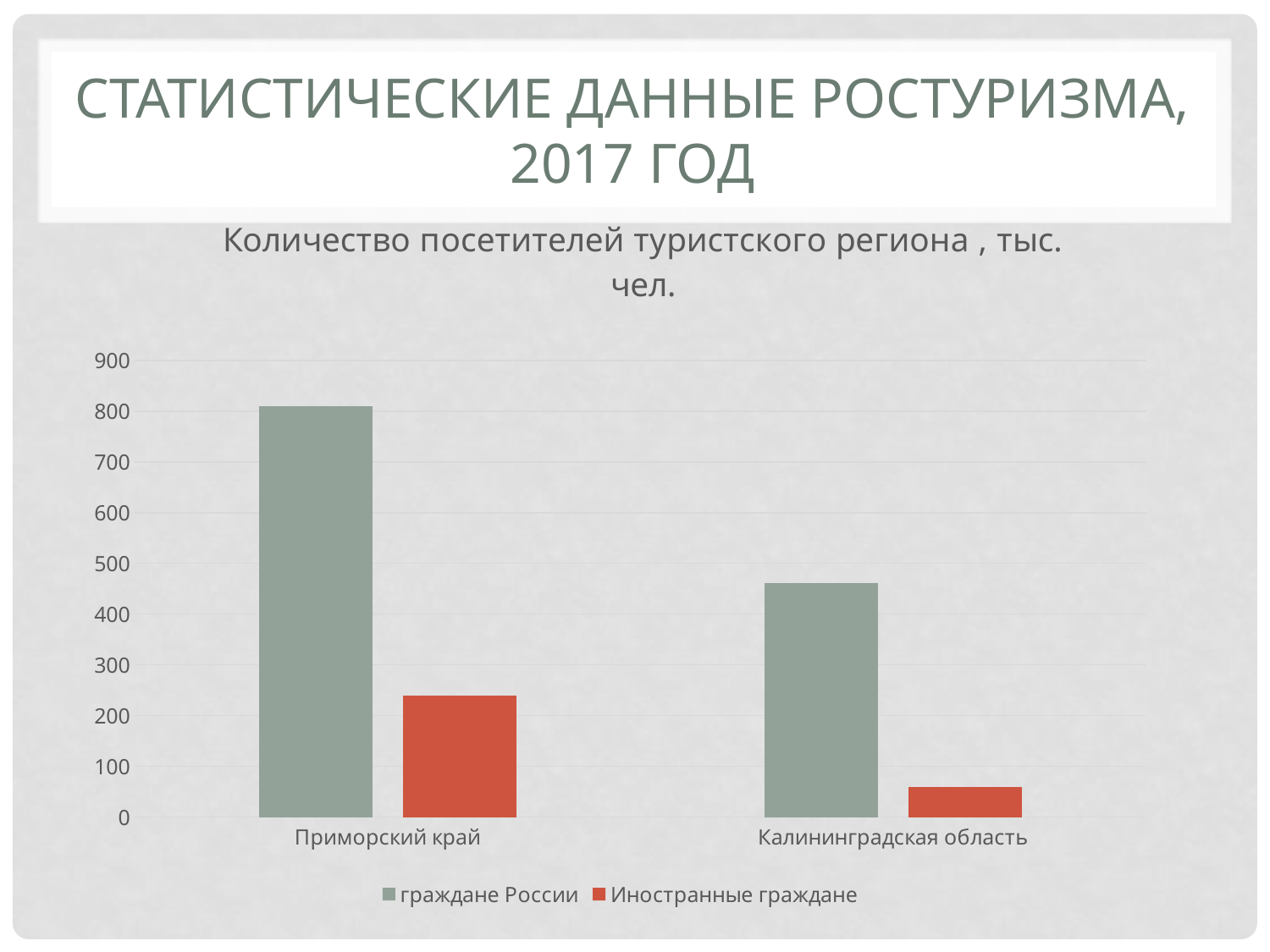
Which category has the highest value for граждане России? Приморский край Is the value for Иностранные граждане in Калининградская область greater or less than 100? less Is the value for Иностранные граждане in Приморский край greater or less than 200? greater Which series is shown in red? Иностранные граждане How many categories are shown on the x axis? 2 What is the title of the chart? Количество посетителей туристского региона , тыс. чел. How many series does the legend list? 2 Is the value for граждане России in Приморский край greater or less than 700? greater Which category has the lowest value for Иностранные граждане? Калининградская область In Калининградская область, which is larger: граждане России or Иностранные граждане? граждане России What kind of chart is shown on the slide? bar chart